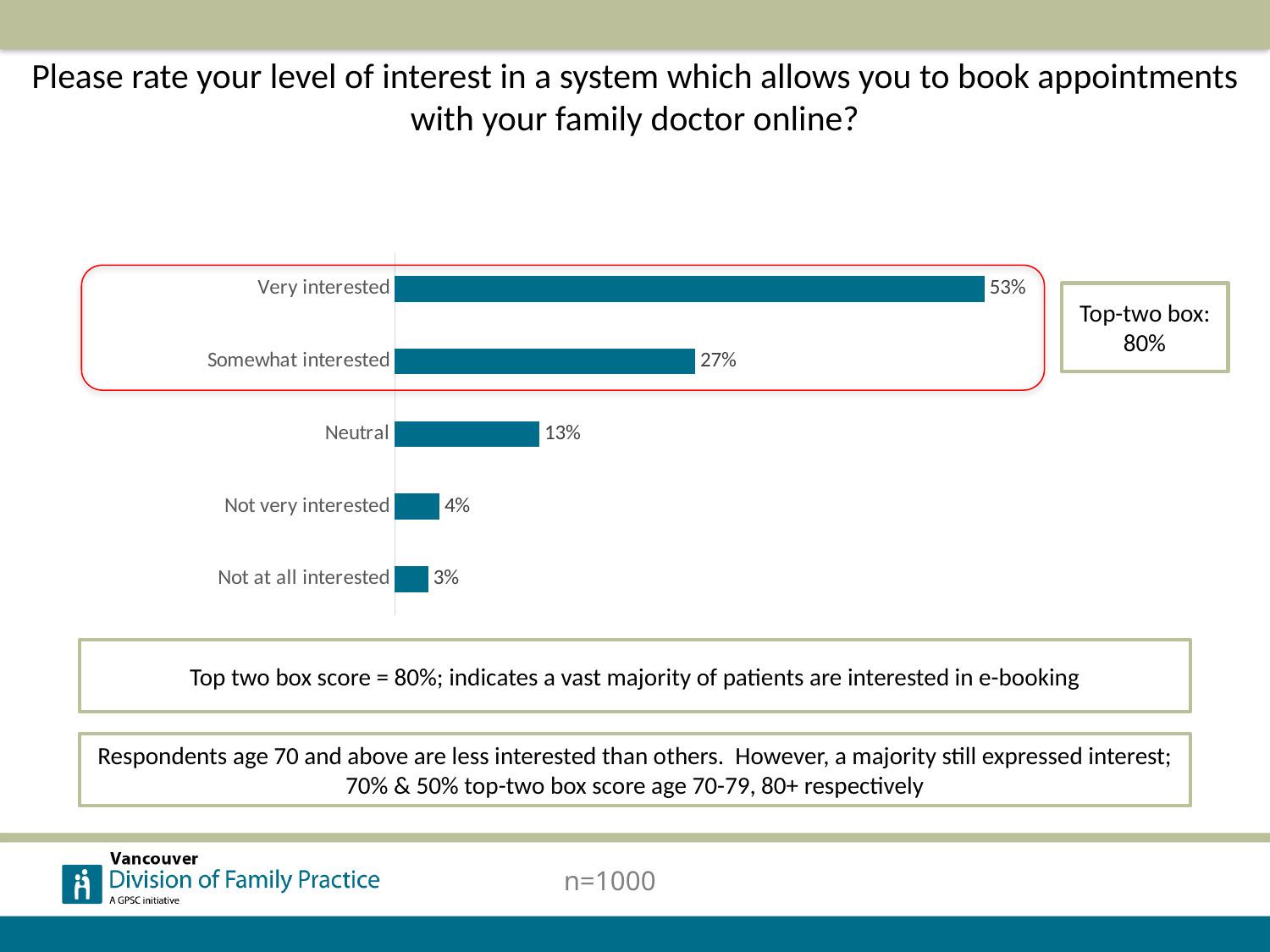
What is the top-two box score shown next to the chart? 80% What percentage of respondents were somewhat interested? 27% What is the sample size (n) shown on the slide? n=1000 Which is larger, the percentage for Neutral or for Not very interested? Neutral How many response categories are shown in the chart? 5 Which response category has the highest percentage? Very interested What type of chart is shown on the slide? Bar chart What is the difference in percentage points between Very interested and Somewhat interested? 26 What percentage of respondents were neutral? 13% What percentage of respondents were not at all interested? 3% What percentage of respondents were very interested? 53% Which response category has the lowest percentage? Not at all interested